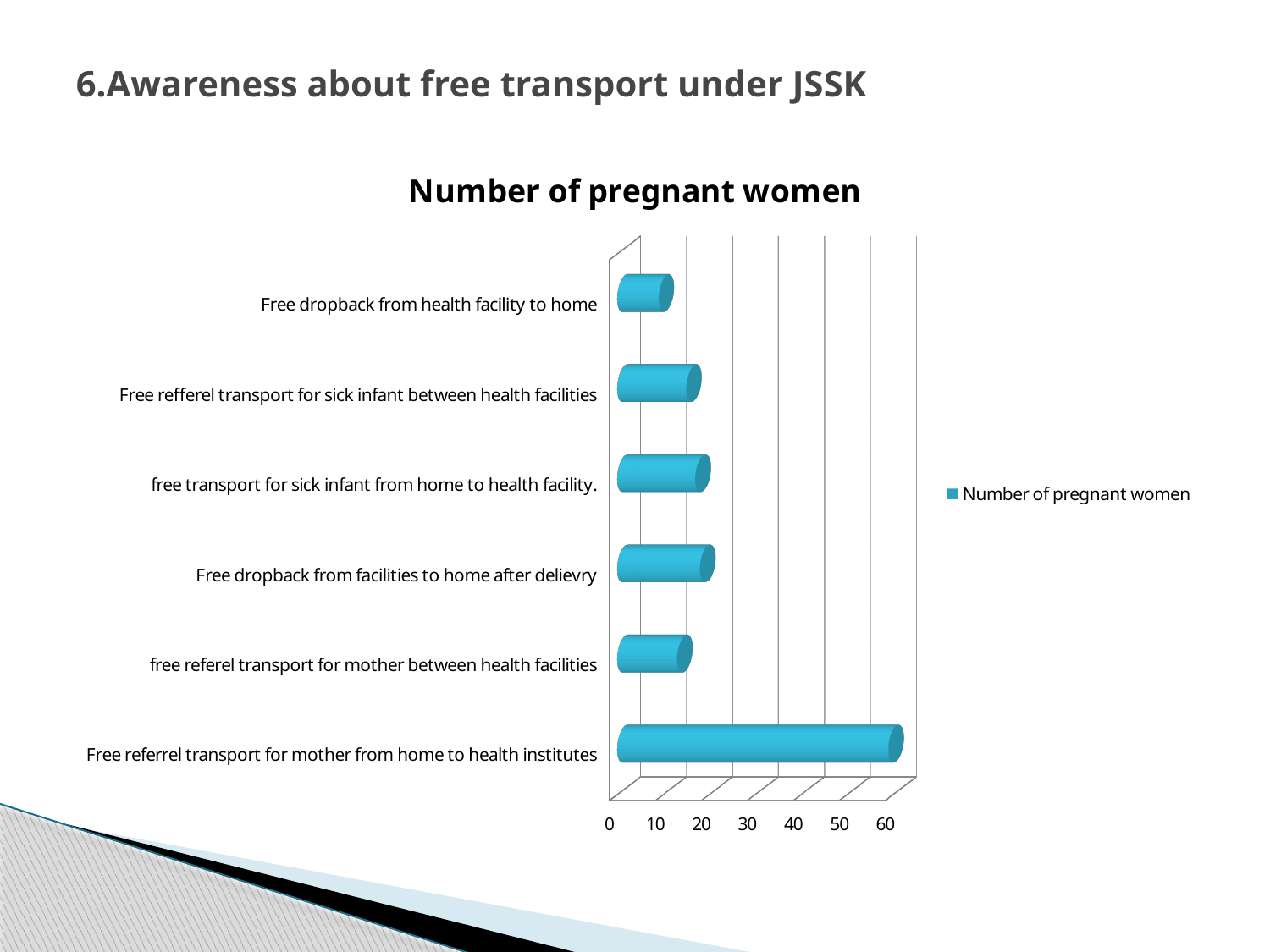
What is the title of the chart? Number of pregnant women Which category has the highest number of pregnant women? Free referrel transport for mother from home to health institutes Is the value for 'Free refferel transport for sick infant between health facilities' greater or less than 30? less What is the legend entry shown on the chart? Number of pregnant women How many categories are plotted in the chart? 6 Which is larger: the value for 'Free dropback from facilities to home after delievry' or 'Free dropback from health facility to home'? Free dropback from facilities to home after delievry Is the value for 'free referel transport for mother between health facilities' greater or less than 40? less Which is larger: the value for 'Free referrel transport for mother from home to health institutes' or 'free transport for sick infant from home to health facility.'? Free referrel transport for mother from home to health institutes Is the value for 'Free dropback from health facility to home' greater or less than 20? less How many series does the legend list? 1 What kind of chart is shown on the slide? bar chart